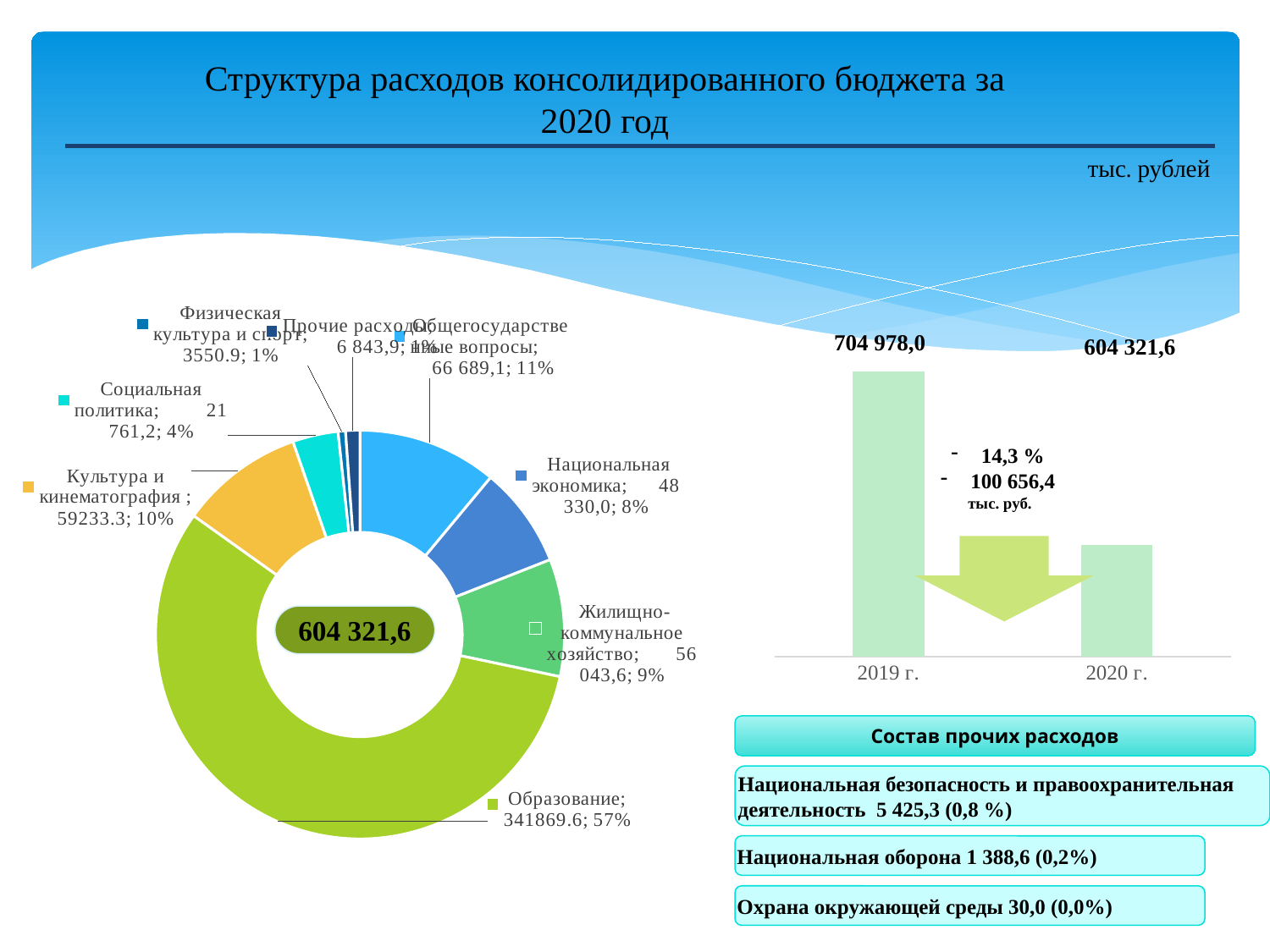
In the doughnut chart on the left, what value is shown for Образование? 341869.6 In the bar chart on the right, what value is shown for 2019 г.? 704 978,0 In the doughnut chart on the left, which is larger: Национальная экономика or Социальная политика? Национальная экономика In the bar chart on the right, by how much did the value decrease from 2019 г. to 2020 г.? 100 656,4 What kind of chart is on the right side of the slide, comparing 2019 г. and 2020 г.? bar chart In the bar chart on the right, what value is shown for 2020 г.? 604 321,6 In the doughnut chart on the left, which category has the largest share? Образование In the doughnut chart on the left, what percentage is shown for Жилищно-коммунальное хозяйство? 9% In the doughnut chart on the left, what total value is shown in the centre of the ring? 604 321,6 In the doughnut chart on the left, what share of the total does Образование account for? 57% What kind of chart is on the left side of the slide? doughnut (pie) chart In the doughnut chart on the left, what value is shown for Культура и кинематография? 59233.3